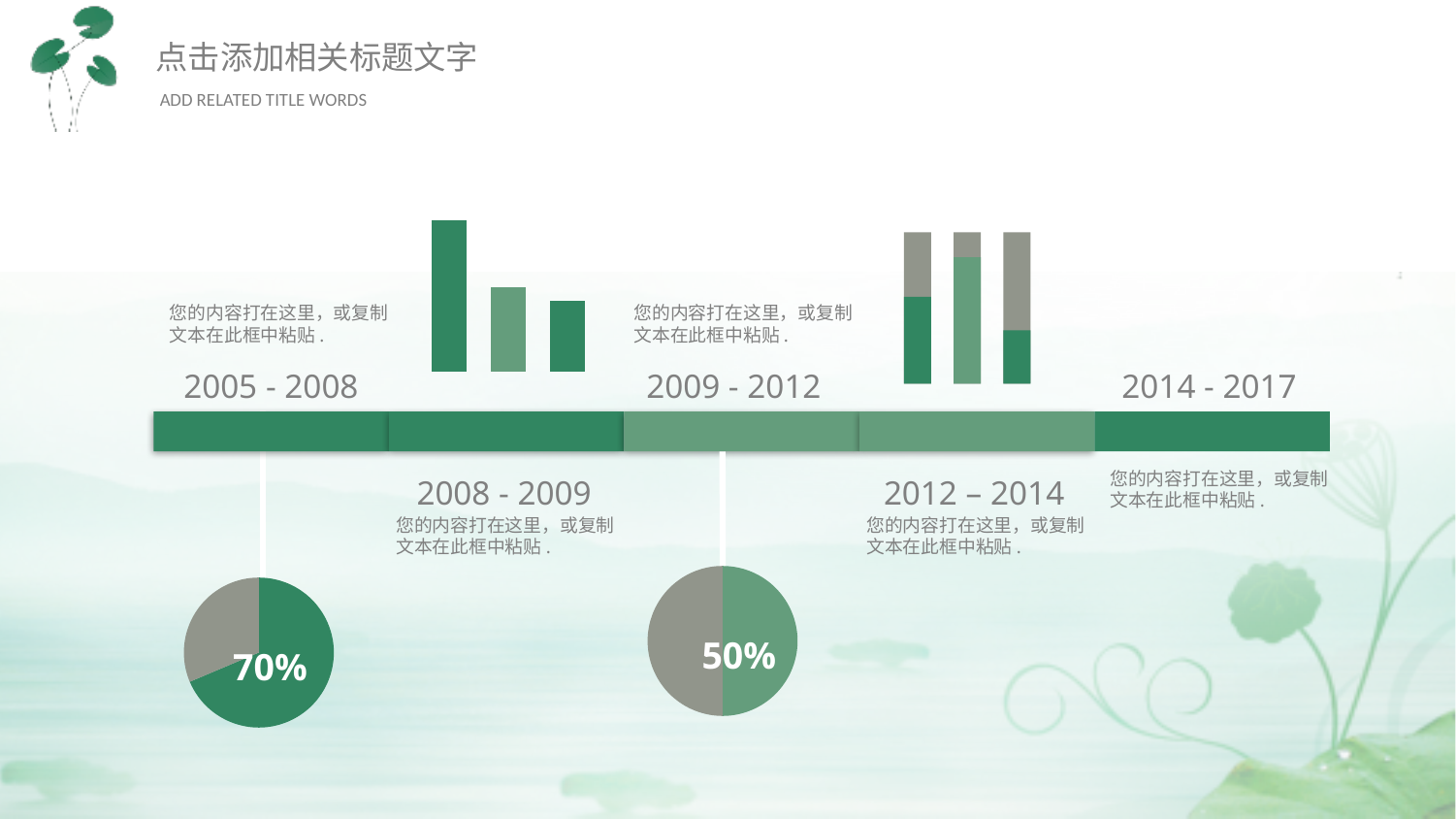
What two colours are used in the pie chart showing 70%? Green and grey What percentage is shown on the pie chart on the left side of the slide? 70% How many pie charts are on the slide? 2 In the bar chart above the 2005 - 2008 label, which bar is the shortest? The rightmost bar In the stacked bar chart above the 2009 - 2012 label, which bar has the largest green segment? The middle bar What percentage is shown on the pie chart in the middle of the slide? 50% What kind of chart is the chart above the 2005 - 2008 label? Bar chart How many bars does the stacked bar chart above the 2009 - 2012 label have? 3 What is the difference between the percentages shown on the two pie charts? 20% Which pie chart shows the larger percentage, the left one or the middle one? The left one (70%) In the bar chart above the 2005 - 2008 label, which bar is the tallest? The leftmost bar How many bars does the bar chart above the 2005 - 2008 label have? 3